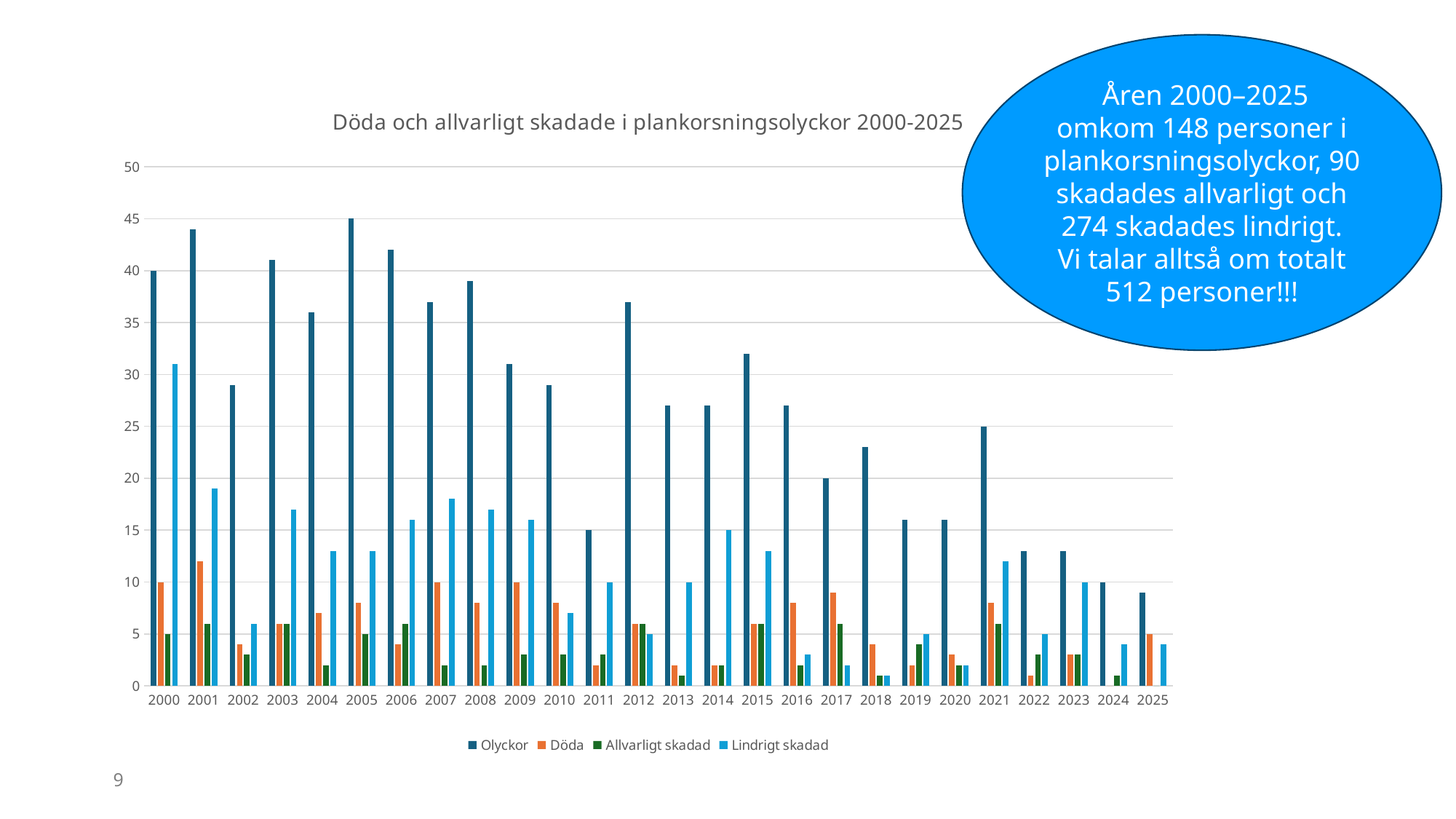
Do the Olyckor values generally rise or fall from 2000 to 2025? fall What is the value of Döda for 2000? 10 What is the value of Lindrigt skadad for 2023? 10 How many series does the legend list? 4 How many years are shown on the x axis? 26 Is the value of Lindrigt skadad for 2001 greater or less than 20? less Is the value of Olyckor for 2001 greater or less than 40? greater What is the value of Olyckor for 2000? 40 What kind of chart is shown on the slide? bar chart What is the value of Olyckor for 2005? 45 Which is larger in 2015, Olyckor or Lindrigt skadad? Olyckor In which year is Lindrigt skadad highest? 2000